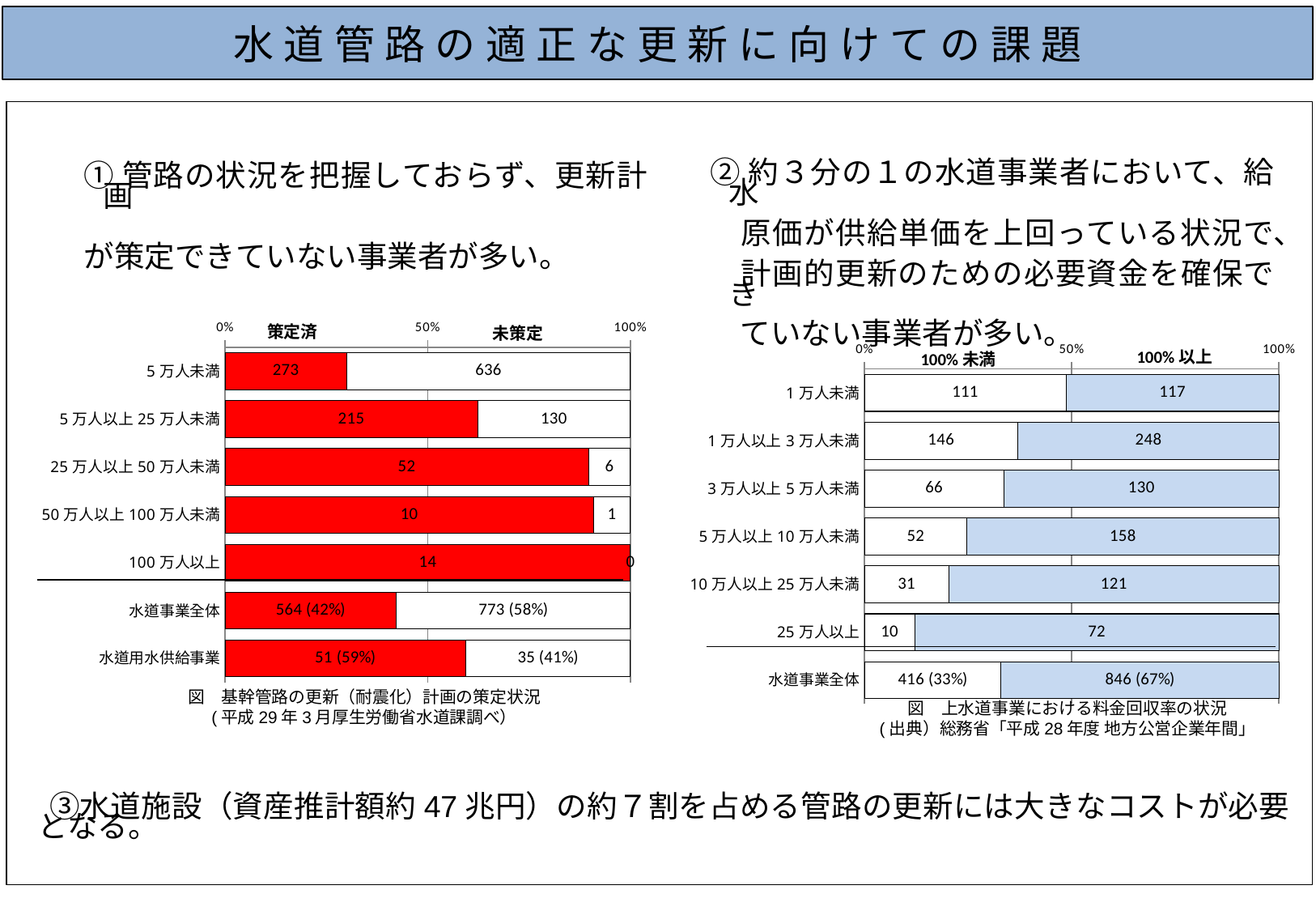
In the right chart (上水道事業における料金回収率の状況), what is the 100%未満 value for 25万人以上? 10 In the right chart (上水道事業における料金回収率の状況), how many categories are shown? 7 In the right chart (上水道事業における料金回収率の状況), which category has the highest 100%以上 value? 水道事業全体 In the right chart (上水道事業における料金回収率の状況), what is the 100%以上 value for 1万人以上3万人未満? 248 In the left chart (基幹管路の更新（耐震化）計画の策定状況), what kind of chart is it? Stacked horizontal bar chart In the left chart (基幹管路の更新（耐震化）計画の策定状況), what is the total of 策定済 and 未策定 for 5万人未満? 909 In the left chart (基幹管路の更新（耐震化）計画の策定状況), what is the 策定済 value for 5万人未満? 273 In the left chart (基幹管路の更新（耐震化）計画の策定状況), what is the 策定済 label for 水道事業全体? 564 (42%) In the left chart (基幹管路の更新（耐震化）計画の策定状況), what is the 未策定 value for 5万人以上25万人未満? 130 In the right chart (上水道事業における料金回収率の状況), what is the 100%以上 label for 水道事業全体? 846 (67%) In the right chart (上水道事業における料金回収率の状況), what is the difference between the 100%以上 and 100%未満 values for 5万人以上10万人未満? 106